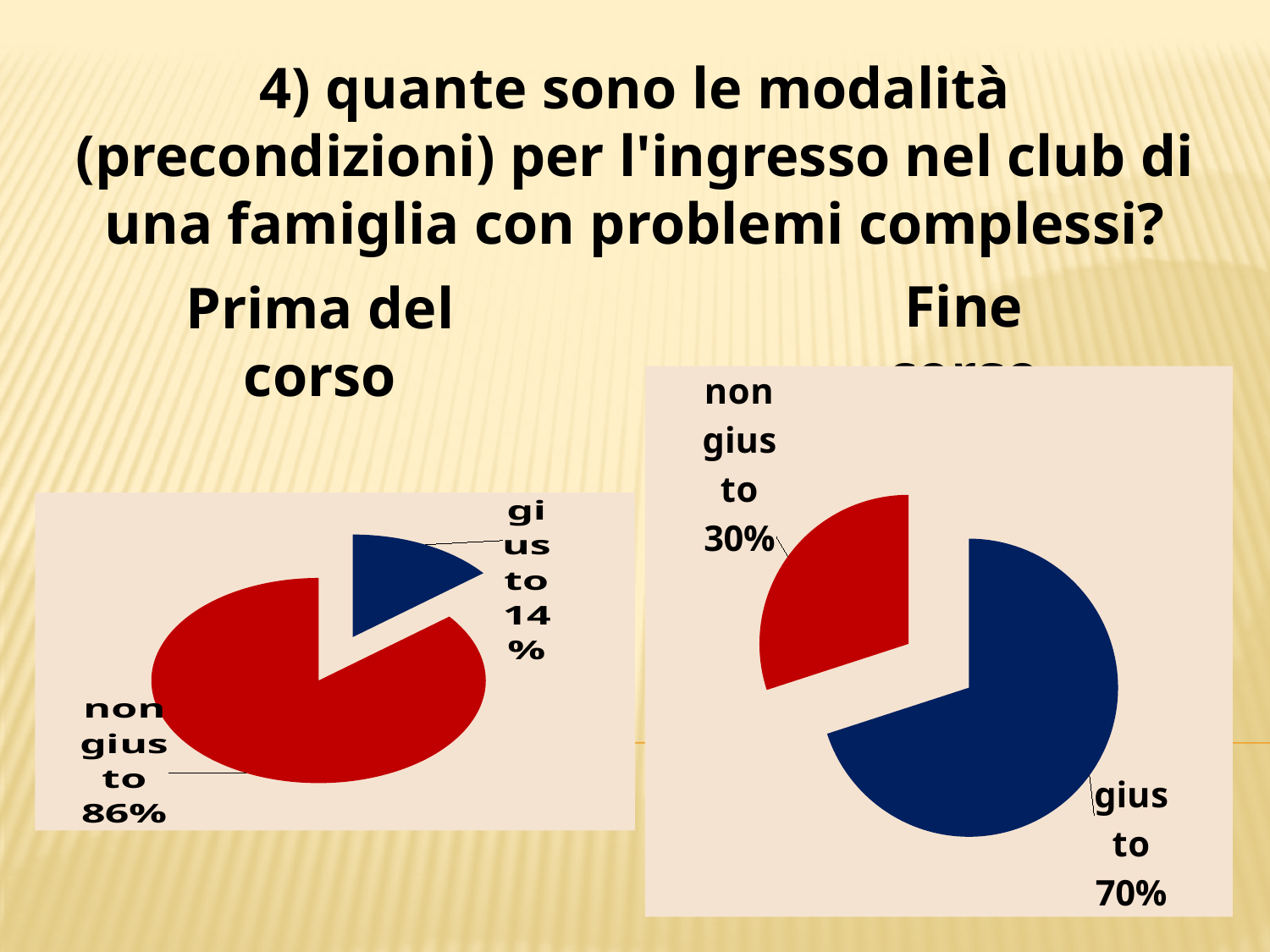
In the 'Fine corso' pie chart on the right, what is the difference between the 'giusto' and 'non giusto' shares? 40% In the 'Fine corso' pie chart on the right, which slice is the smallest? non giusto How many slices does the 'Prima del corso' pie chart on the left have? 2 In the 'Fine corso' pie chart on the right, what share is labelled 'non giusto'? 30% In the 'Prima del corso' pie chart on the left, what share is labelled 'non giusto'? 86% In the 'Prima del corso' pie chart on the left, what share is labelled 'giusto'? 14% What type of chart is used on the right under 'Fine corso'? Pie chart In the 'Prima del corso' pie chart on the left, what is the difference between the 'non giusto' and 'giusto' shares? 72% In the 'Fine corso' pie chart on the right, what share is labelled 'giusto'? 70% Which is larger: the 'giusto' share in the 'Fine corso' chart on the right or the 'giusto' share in the 'Prima del corso' chart on the left? Fine corso In the 'Prima del corso' pie chart on the left, which slice is the largest? non giusto In the 'Fine corso' pie chart on the right, what colour is the 'giusto' slice? Blue